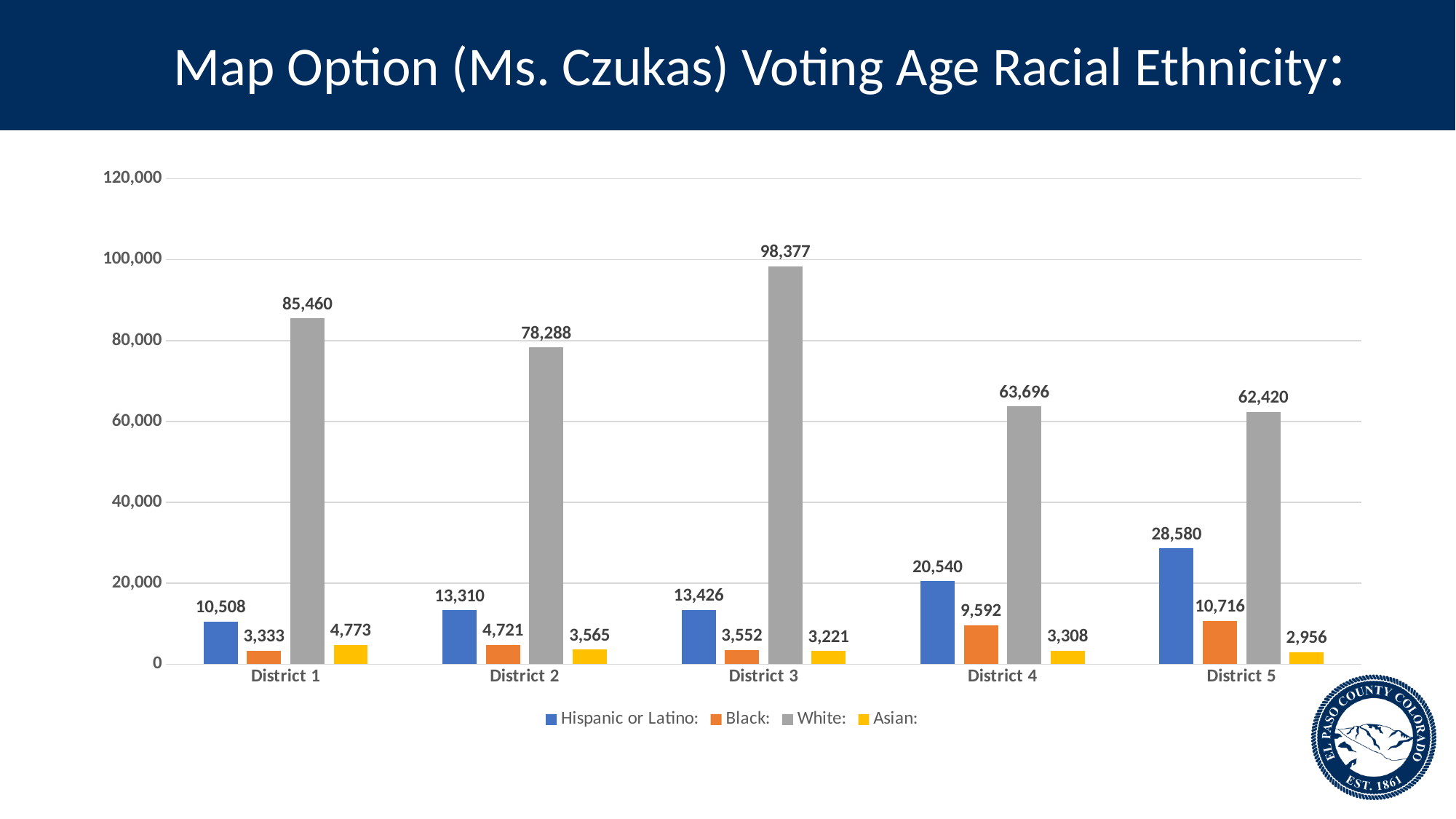
Which district has the lowest Asian value? District 5 Which district has the highest White value? District 3 What is the Hispanic or Latino value for District 5? 28,580 What is the White voting age population in District 3? 98,377 What is the difference between the White values for District 1 and District 2? 7,172 How many districts are shown on the x axis? 5 Which is larger, the Black value for District 5 or the Hispanic or Latino value for District 1? Black value for District 5 What is the Asian value for District 1? 4,773 What kind of chart is shown on the slide? bar chart How many series does the legend list? 4 What is the Black value for District 4? 9,592 Is the Hispanic or Latino value for District 4 greater or less than 20,000? greater